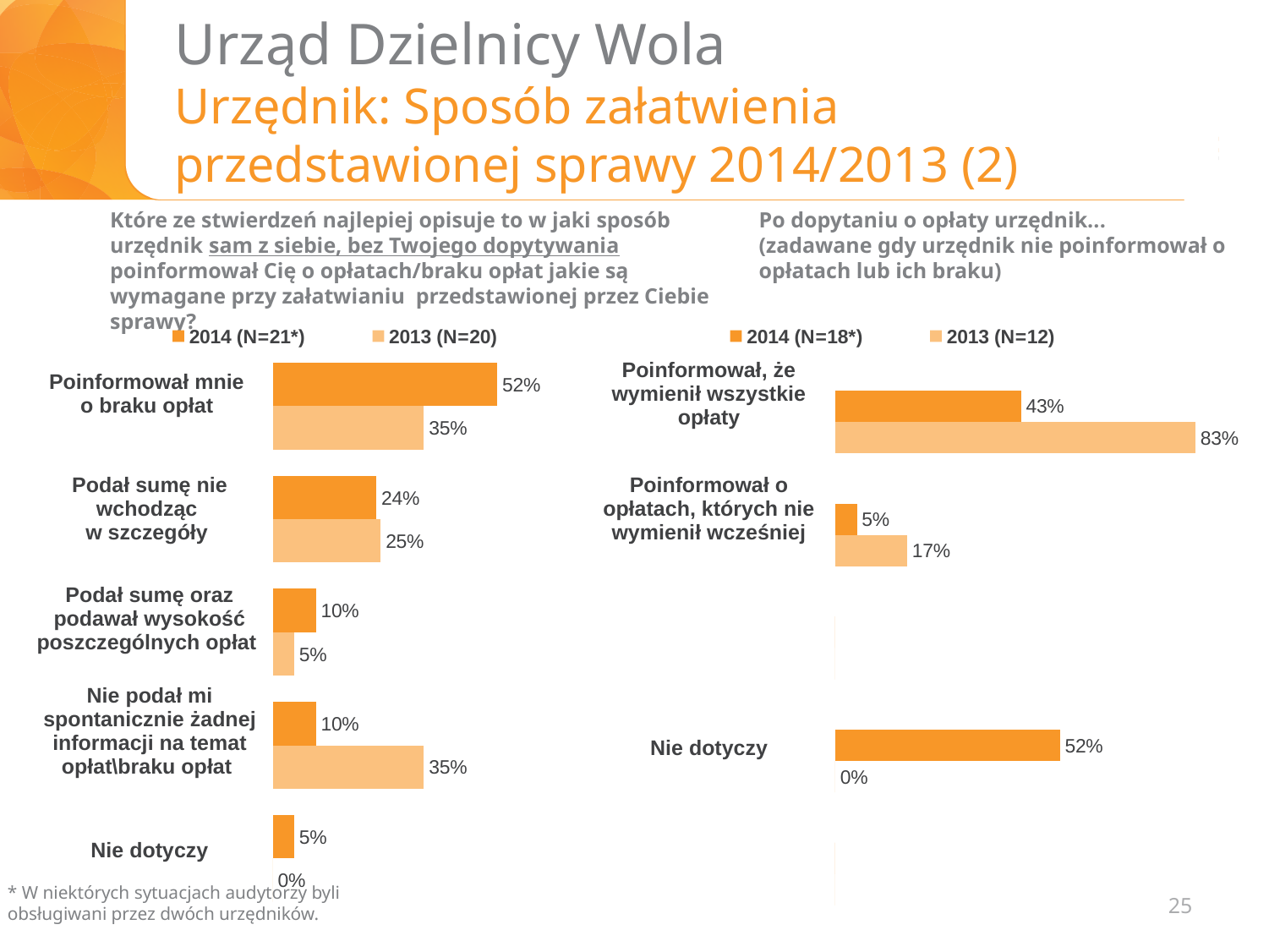
In the left chart, what is the difference between the 2014 and 2013 values for "Poinformował mnie o braku opłat"? 17 percentage points In the right chart, what is the 2014 value for "Nie dotyczy"? 52% In the right chart, what is the 2013 value for "Poinformował, że wymienił wszystkie opłaty"? 83% What type of chart is the left chart? Bar chart In the left chart, what is the 2013 value for "Nie podał mi spontanicznie żadnej informacji na temat opłat\braku opłat"? 35% How many categories does the left chart show? 5 How many series does the legend of the right chart list? 2 In the right chart, what is the difference between the 2013 and 2014 values for "Poinformował, że wymienił wszystkie opłaty"? 40 percentage points In the right chart, which category has the lowest 2014 value? Poinformował o opłatach, których nie wymienił wcześniej In the left chart, what is the 2014 value for "Poinformował mnie o braku opłat"? 52% In the left chart, which category has the highest 2014 value? Poinformował mnie o braku opłat In the left chart, is the 2014 or the 2013 value larger for "Podał sumę nie wchodząc w szczegóły"? 2013